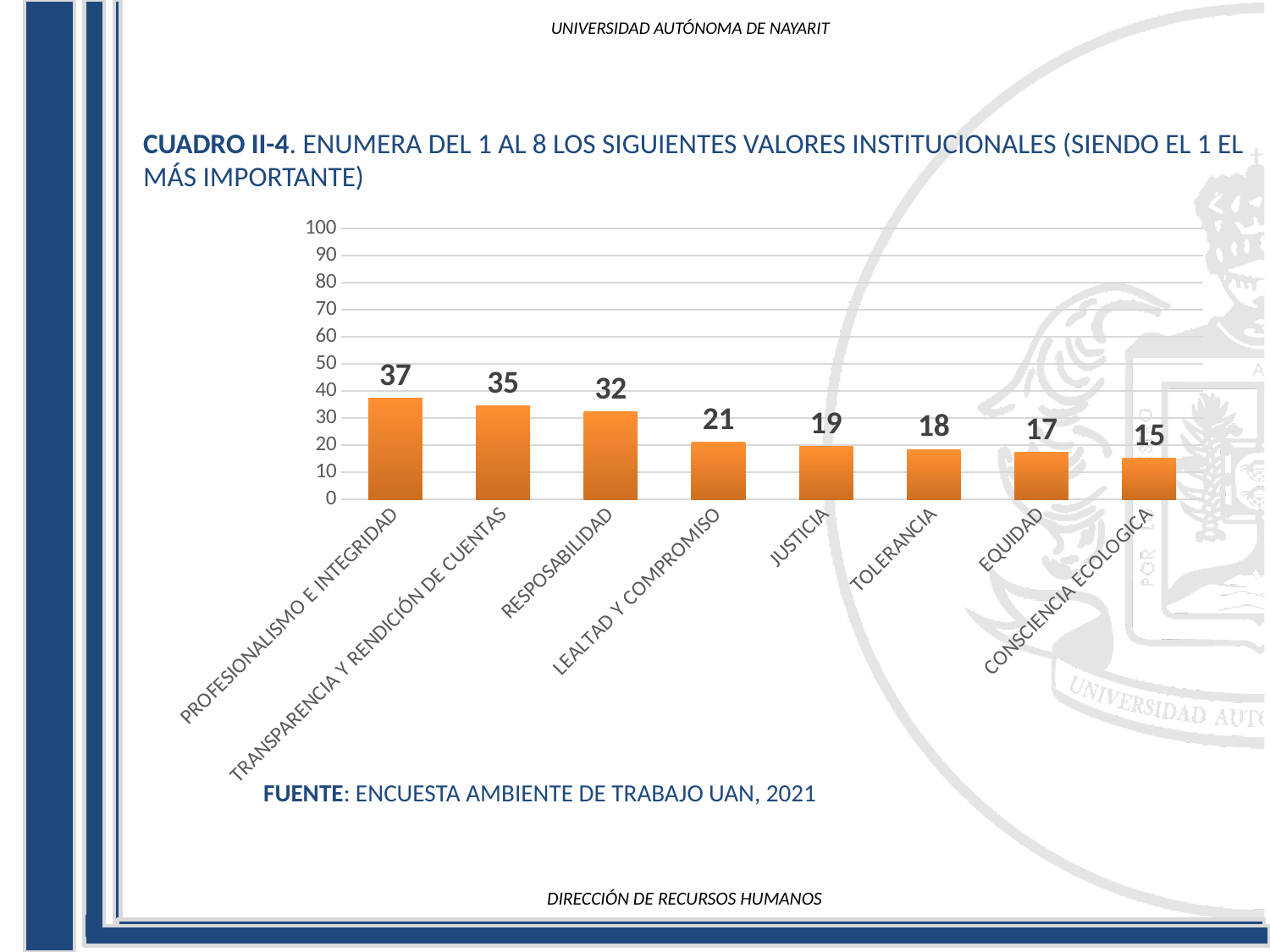
Which category has the highest value? PROFESIONALISMO E INTEGRIDAD Is the value for EQUIDAD greater or less than 20? less What is the difference between the values for TRANSPARENCIA Y RENDICIÓN DE CUENTAS and LEALTAD Y COMPROMISO? 14 What kind of chart is shown on the slide? bar chart What source is cited below the chart? ENCUESTA AMBIENTE DE TRABAJO UAN, 2021 What is the value for CONSCIENCIA ECOLOGICA? 15 How many categories are shown on the x axis? 8 Which is larger, the value for RESPOSABILIDAD or the value for TOLERANCIA? RESPOSABILIDAD What is the value for JUSTICIA? 19 What is the value for PROFESIONALISMO E INTEGRIDAD? 37 Which category has the lowest value? CONSCIENCIA ECOLOGICA Do the values rise or fall from left to right along the x axis? fall